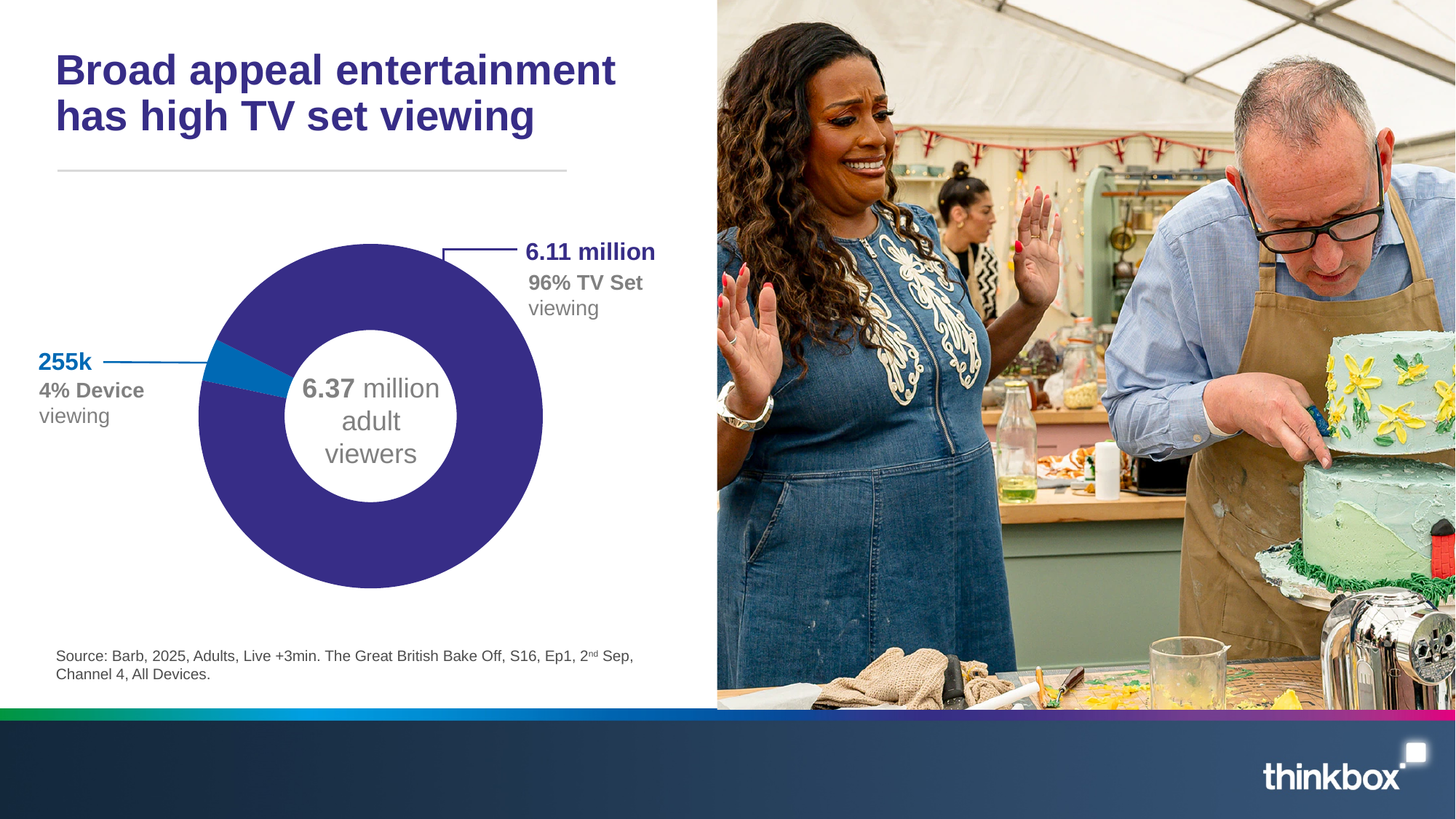
What is the title of the slide containing the chart? Broad appeal entertainment has high TV set viewing What is the value for TV Set viewing? 6.11 million How many segments does the doughnut chart have? 2 How many adult viewers does the centre of the doughnut chart show in total? 6.37 million What colour is the Device viewing segment? Blue What share of viewing is Device viewing? 4% What is the value for Device viewing? 255k What kind of chart is shown on the slide? Doughnut chart Which segment is larger, TV Set viewing or Device viewing? TV Set viewing Which segment of the doughnut chart is the smallest? Device viewing What share of viewing is TV Set viewing? 96%